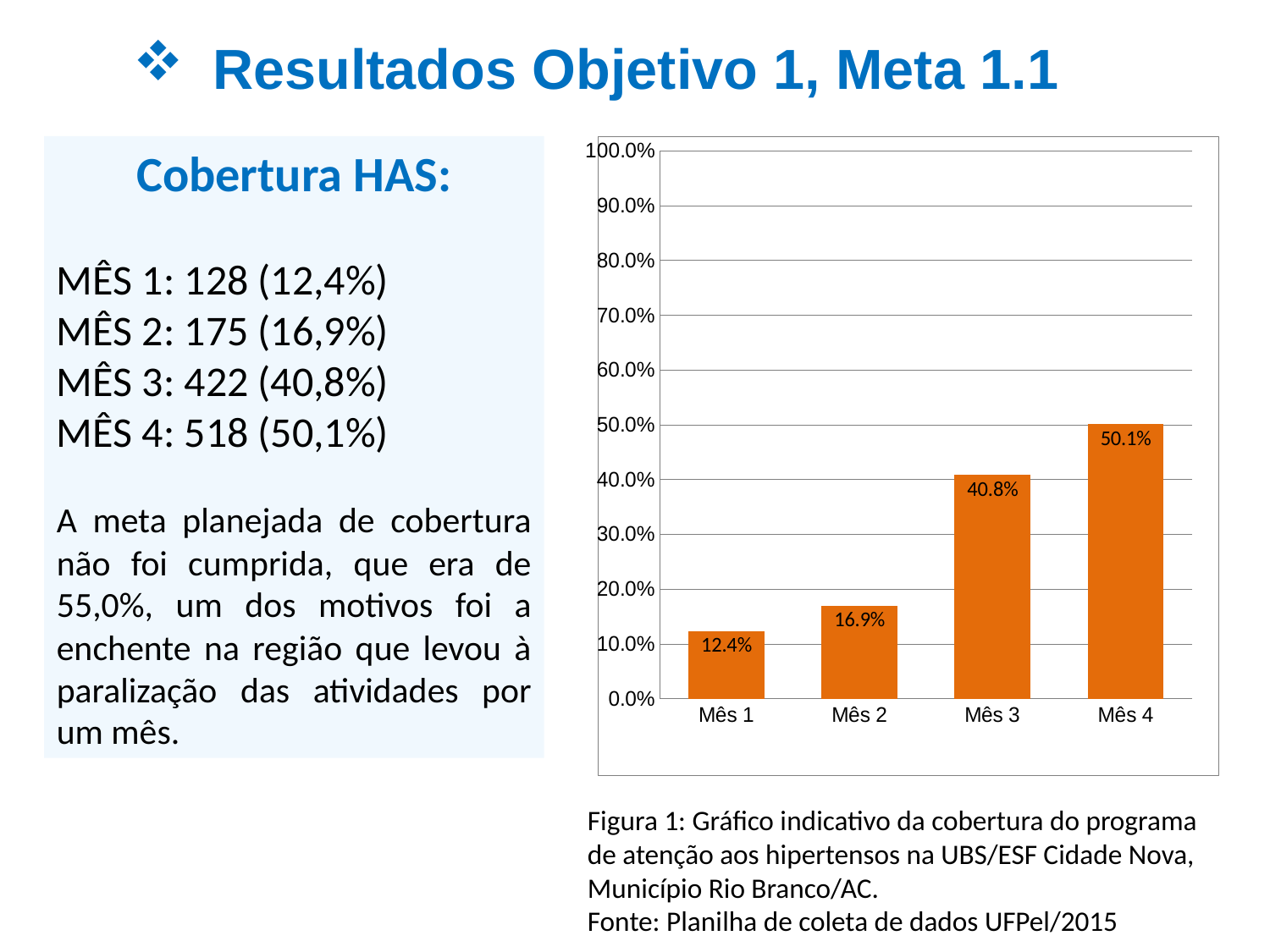
What is the value for Mês 3 in the chart? 40.8% Is the value for Mês 4 greater or less than 40.0%? greater What kind of chart is shown on the slide? bar chart What is the difference between the values for Mês 4 and Mês 3? 9.3% What is the difference between the values for Mês 2 and Mês 1? 4.5% What is the value for Mês 4 in the chart? 50.1% What is the value for Mês 1 in the chart? 12.4% Which is larger, the value for Mês 2 or the value for Mês 3? Mês 3 Which month has the highest value in the chart? Mês 4 Which month has the lowest value in the chart? Mês 1 Do the values rise or fall from Mês 1 to Mês 4? rise How many months are shown on the x axis of the chart? 4